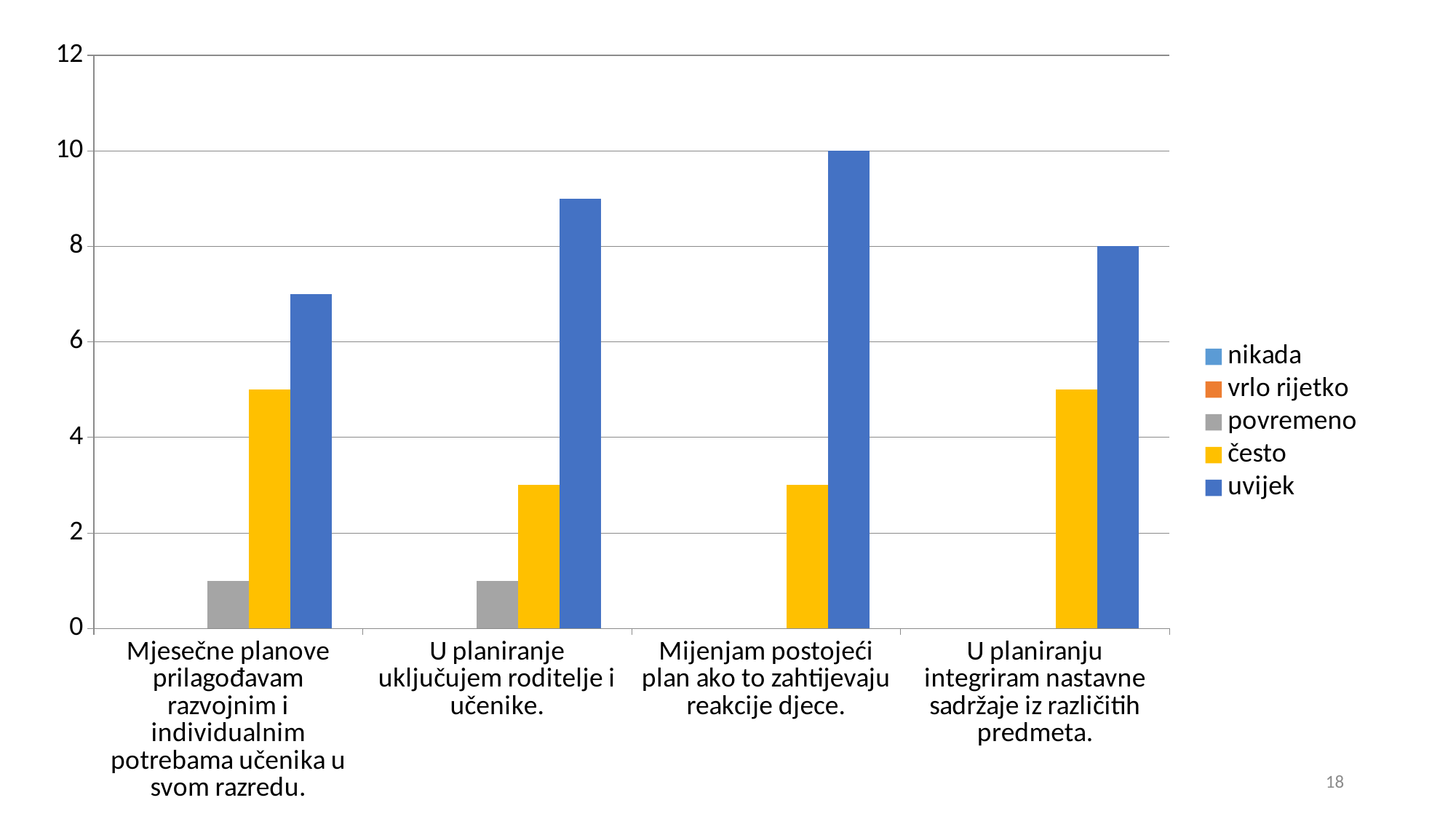
What kind of chart is shown on the slide? bar chart Which is larger for 'U planiranju integriram nastavne sadržaje iz različitih predmeta.': 'često' or 'uvijek'? uvijek What is the value of 'uvijek' for 'Mijenjam postojeći plan ako to zahtijevaju reakcije djece.'? 10 Which category has the highest 'uvijek' value? Mijenjam postojeći plan ako to zahtijevaju reakcije djece. Is the 'često' value for 'Mjesečne planove prilagođavam razvojnim i individualnim potrebama učenika u svom razredu.' greater or less than 4? greater Is the 'često' value for 'U planiranje uključujem roditelje i učenike.' greater or less than 4? less How many categories are shown on the x axis? 4 Which category has the lowest 'uvijek' value? Mjesečne planove prilagođavam razvojnim i individualnim potrebama učenika u svom razredu. Is the 'uvijek' value for 'U planiranje uključujem roditelje i učenike.' greater or less than 8? greater What colour are the 'često' bars? yellow How many series does the legend list? 5 What is the value of 'uvijek' for 'U planiranju integriram nastavne sadržaje iz različitih predmeta.'? 8